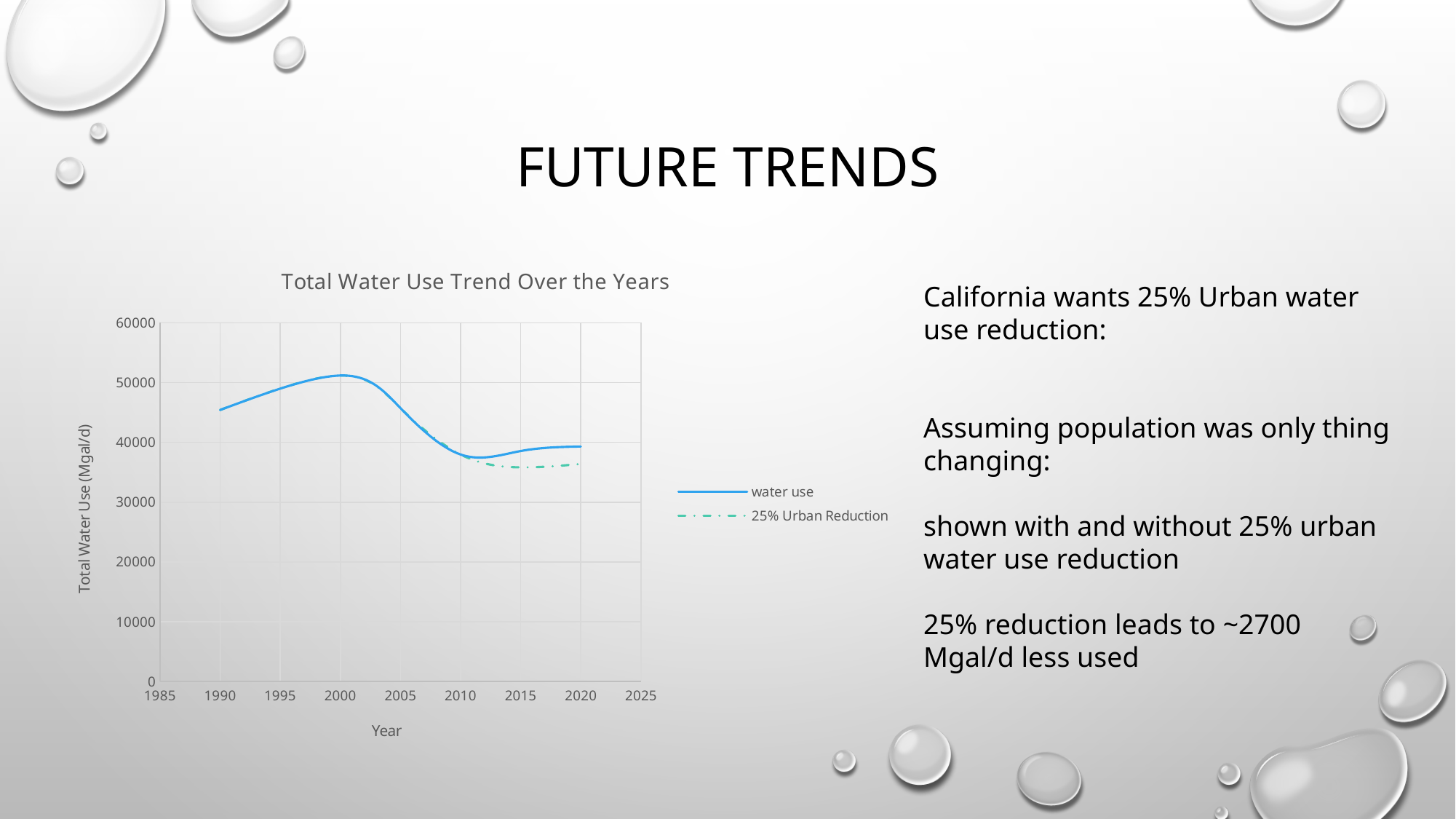
Does the water use series rise or fall between 2000 and 2010? fall What is the title of the chart? Total Water Use Trend Over the Years Is the water use value in 2000 greater or less than 40000? greater What kind of chart is shown on the slide? line chart What is the label of the chart's vertical axis? Total Water Use (Mgal/d) Is the 25% Urban Reduction value in 2015 greater or less than 40000? less How many series does the chart's legend list? 2 Does the water use series rise or fall between 1990 and 2000? rise Is the water use value in 2010 greater or less than 40000? less In 2015, which series has the higher value, water use or 25% Urban Reduction? water use